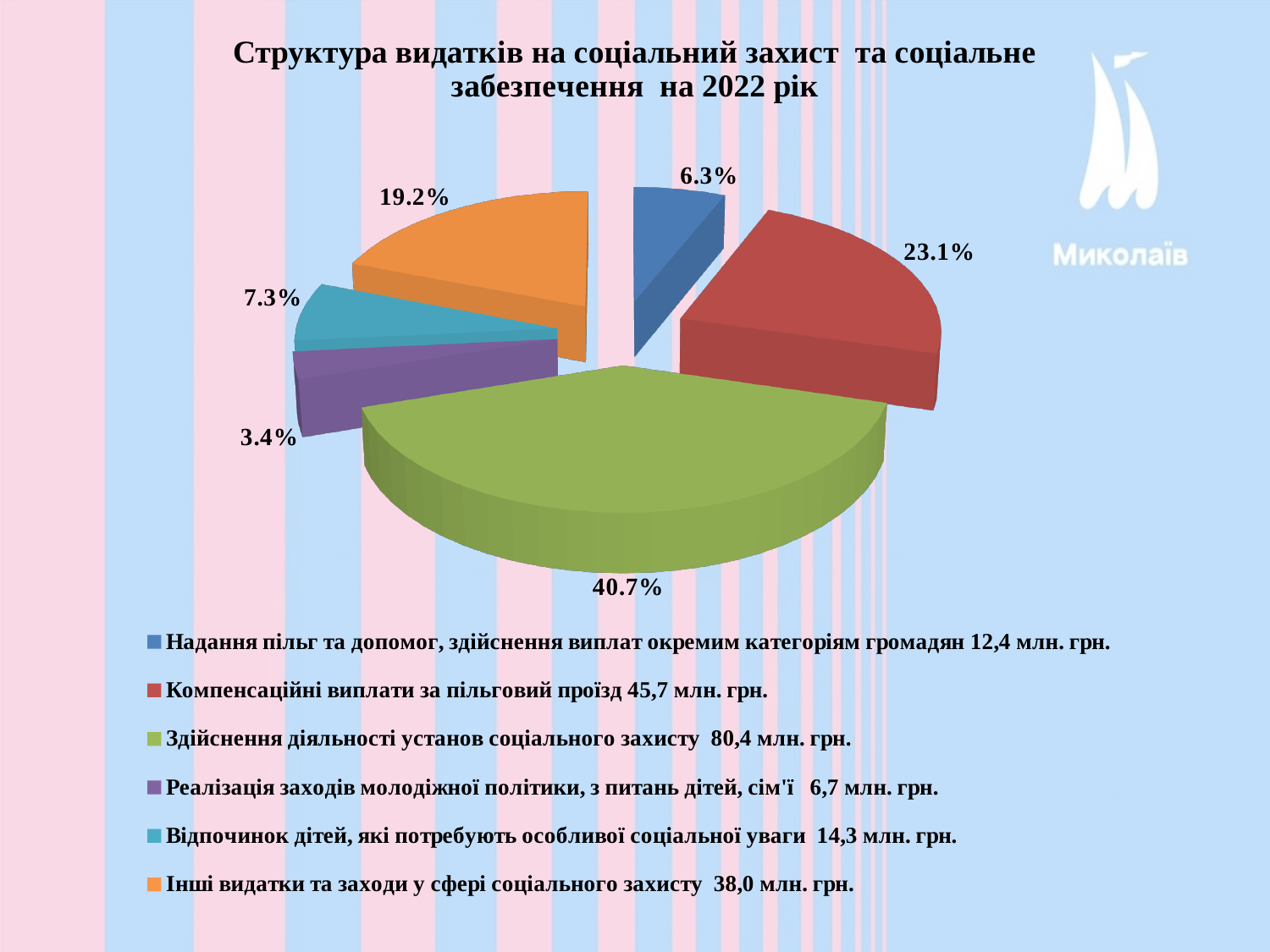
What share of the pie does "Інші видатки та заходи у сфері соціального захисту" take? 19.2% What kind of chart is shown on the slide? Pie chart Which category has the smallest share of the pie? Реалізація заходів молодіжної політики, з питань дітей, сім'ї Which category has the largest share of the pie? Здійснення діяльності установ соціального захисту Which slice is larger: "Відпочинок дітей, які потребують особливої соціальної уваги" or "Надання пільг та допомог, здійснення виплат окремим категоріям громадян"? Відпочинок дітей, які потребують особливої соціальної уваги How many slices does the pie chart have? 6 What share of the pie does "Здійснення діяльності установ соціального захисту" take? 40.7% What year does the chart title refer to? 2022 What is the difference in percentage points between the largest slice (40.7%) and the "Компенсаційні виплати за пільговий проїзд" slice (23.1%)? 17.6 percentage points What share of the pie does "Компенсаційні виплати за пільговий проїзд" take? 23.1% According to the legend, what amount in млн. грн. is given for "Компенсаційні виплати за пільговий проїзд"? 45,7 млн. грн.